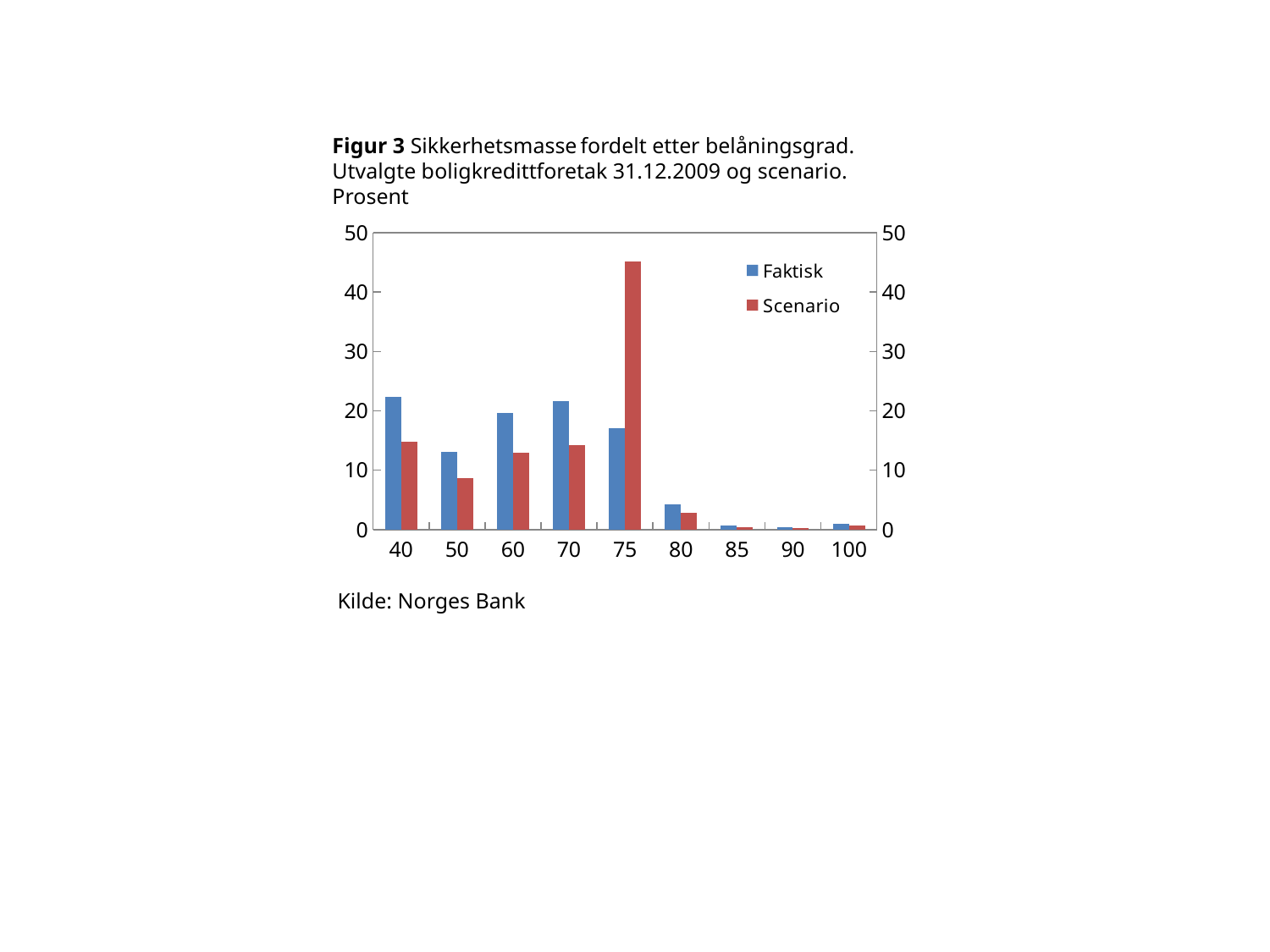
What kind of chart is shown on the slide? bar chart For category 40, which series has the larger value, Faktisk or Scenario? Faktisk What source is cited below the chart? Norges Bank Is the Scenario value for 75 greater or less than 40? greater Which series is shown in red? Scenario Is the Scenario value for 50 greater or less than 10? less For which category is the Scenario value highest? 75 For category 75, which series has the larger value, Faktisk or Scenario? Scenario How many categories are shown on the x axis? 9 How many series does the legend list? 2 Is the Faktisk value for 80 greater or less than 10? less